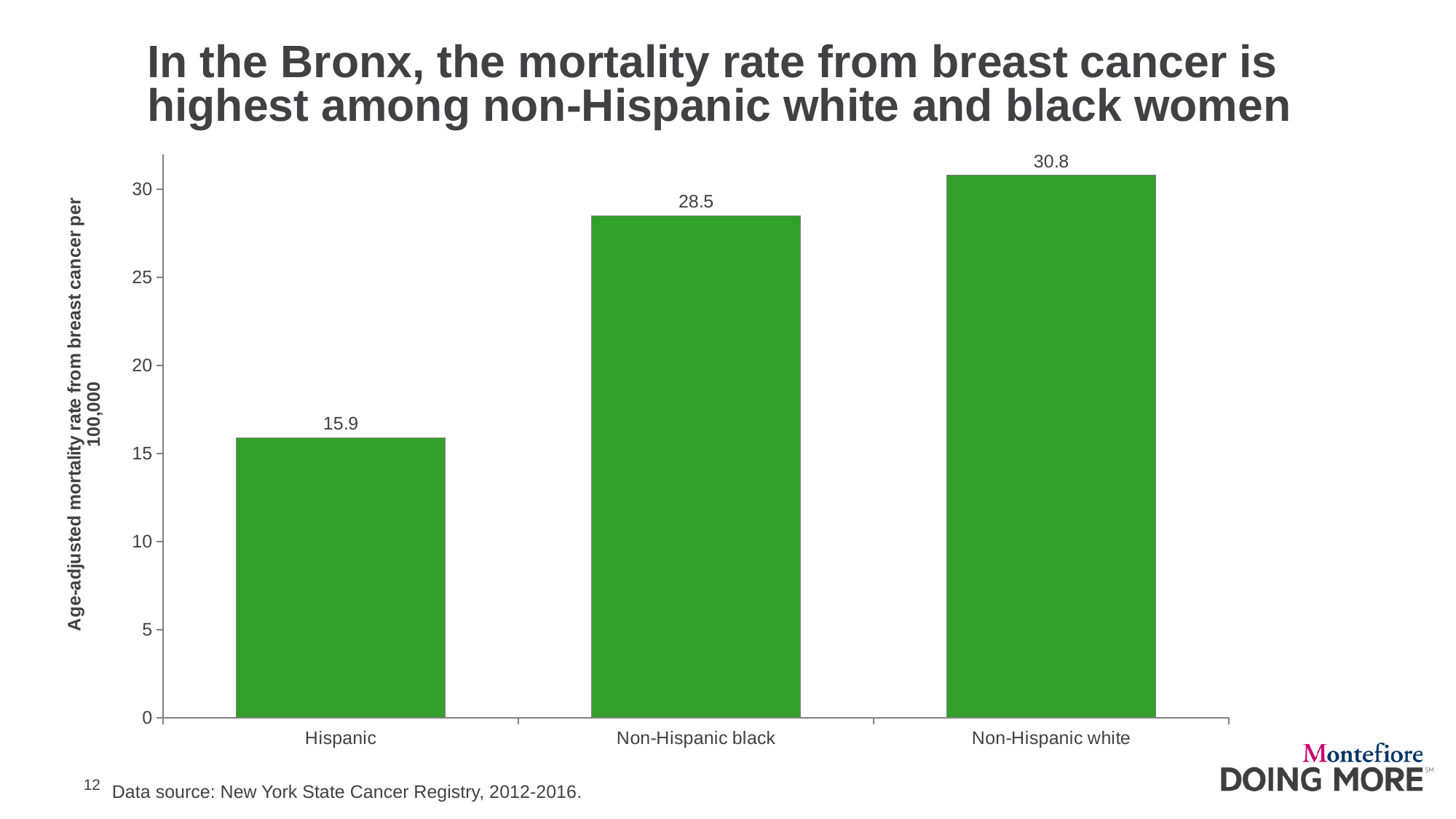
Is the mortality rate for non-Hispanic black women greater or less than 25? greater How many groups are shown on the chart? 3 Which is larger, the mortality rate for non-Hispanic black women or for Hispanic women? Non-Hispanic black What is the difference between the mortality rates for non-Hispanic white and non-Hispanic black women? 2.3 What is the data source cited for the chart? New York State Cancer Registry, 2012-2016 What kind of chart is shown on the slide? Bar chart What is the difference between the mortality rates for non-Hispanic white and Hispanic women? 14.9 Which group has the highest breast cancer mortality rate? Non-Hispanic white Which group has the lowest breast cancer mortality rate? Hispanic What is the age-adjusted breast cancer mortality rate per 100,000 for Hispanic women? 15.9 What is the age-adjusted breast cancer mortality rate per 100,000 for non-Hispanic black women? 28.5 What is the age-adjusted breast cancer mortality rate per 100,000 for non-Hispanic white women? 30.8